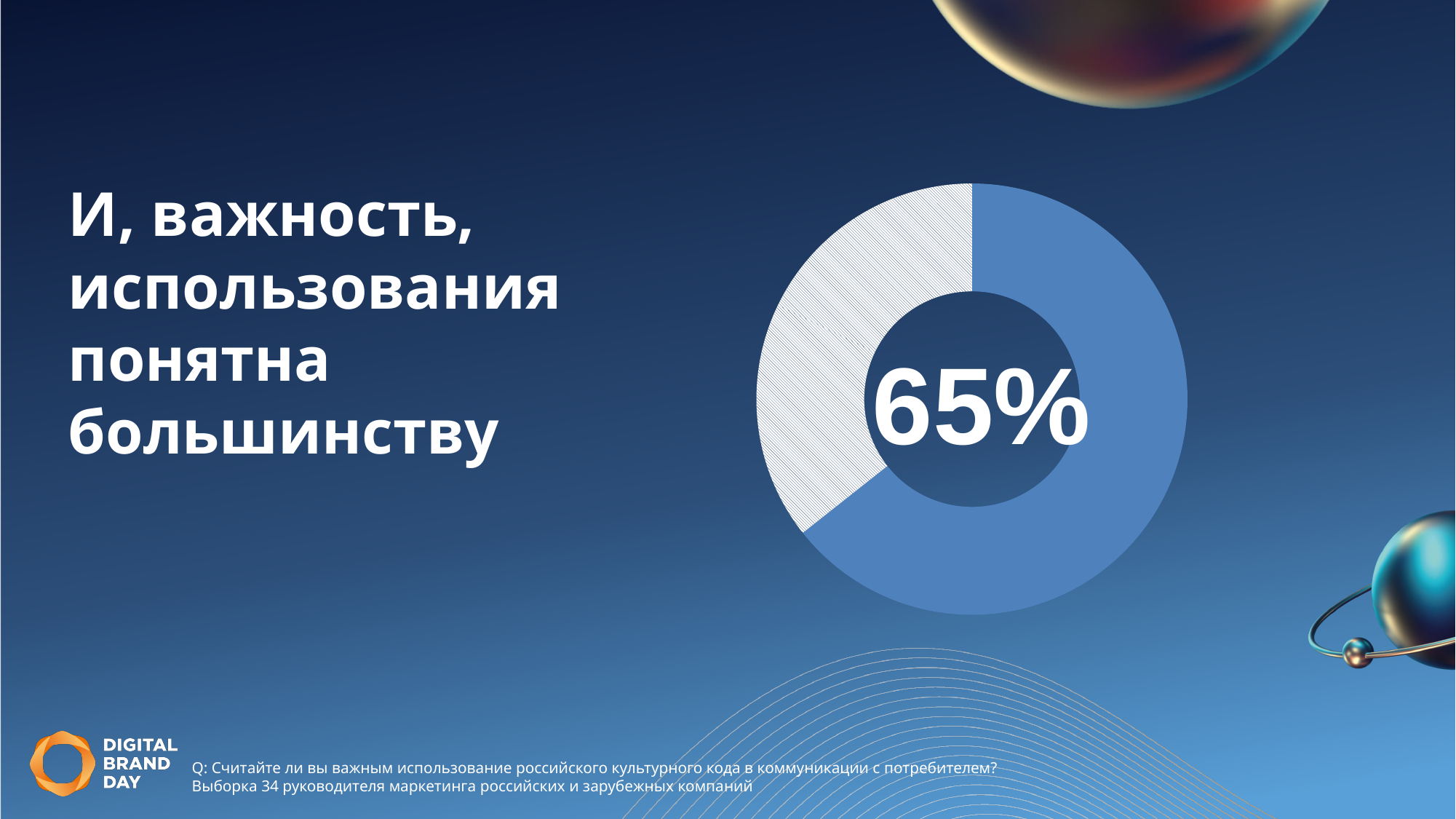
Is the solid blue slice of the donut chart greater or less than 50%? greater What colour is the largest slice of the donut chart? Blue What share of the donut chart does the solid blue slice represent? 65% What kind of chart is shown on the slide? Donut (pie) chart What percentage is printed in the centre of the donut chart? 65% What is the sample size stated below the chart? 34 руководителя маркетинга Is the hatched white slice of the donut chart greater or less than 50%? less Which slice of the donut chart is larger, the solid blue one or the hatched white one? The solid blue one